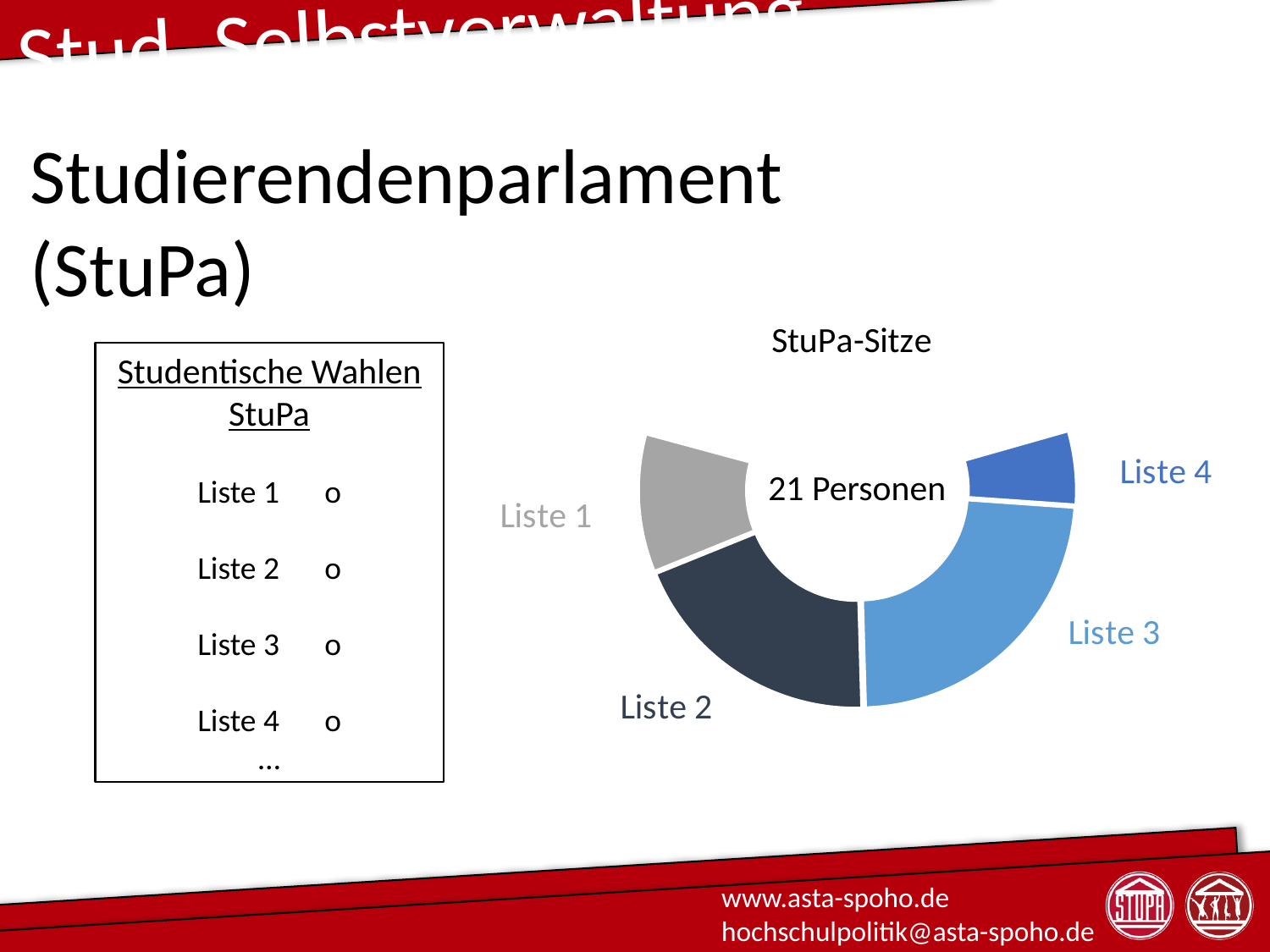
Which list has the smallest segment in the StuPa-Sitze chart? Liste 4 In the StuPa-Sitze chart, which segment is larger, Liste 2 or Liste 4? Liste 2 What kind of chart is the StuPa-Sitze chart? doughnut chart In the StuPa-Sitze chart, which segment is larger, Liste 3 or Liste 1? Liste 3 What text is shown in the centre of the StuPa-Sitze chart? 21 Personen How many segments (lists) does the StuPa-Sitze chart show? 4 In the StuPa-Sitze chart, which segment is larger, Liste 1 or Liste 2? Liste 2 Which list is shown in grey in the StuPa-Sitze chart? Liste 1 Which list has the largest segment in the StuPa-Sitze chart? Liste 3 What is the title of the chart on the slide? StuPa-Sitze